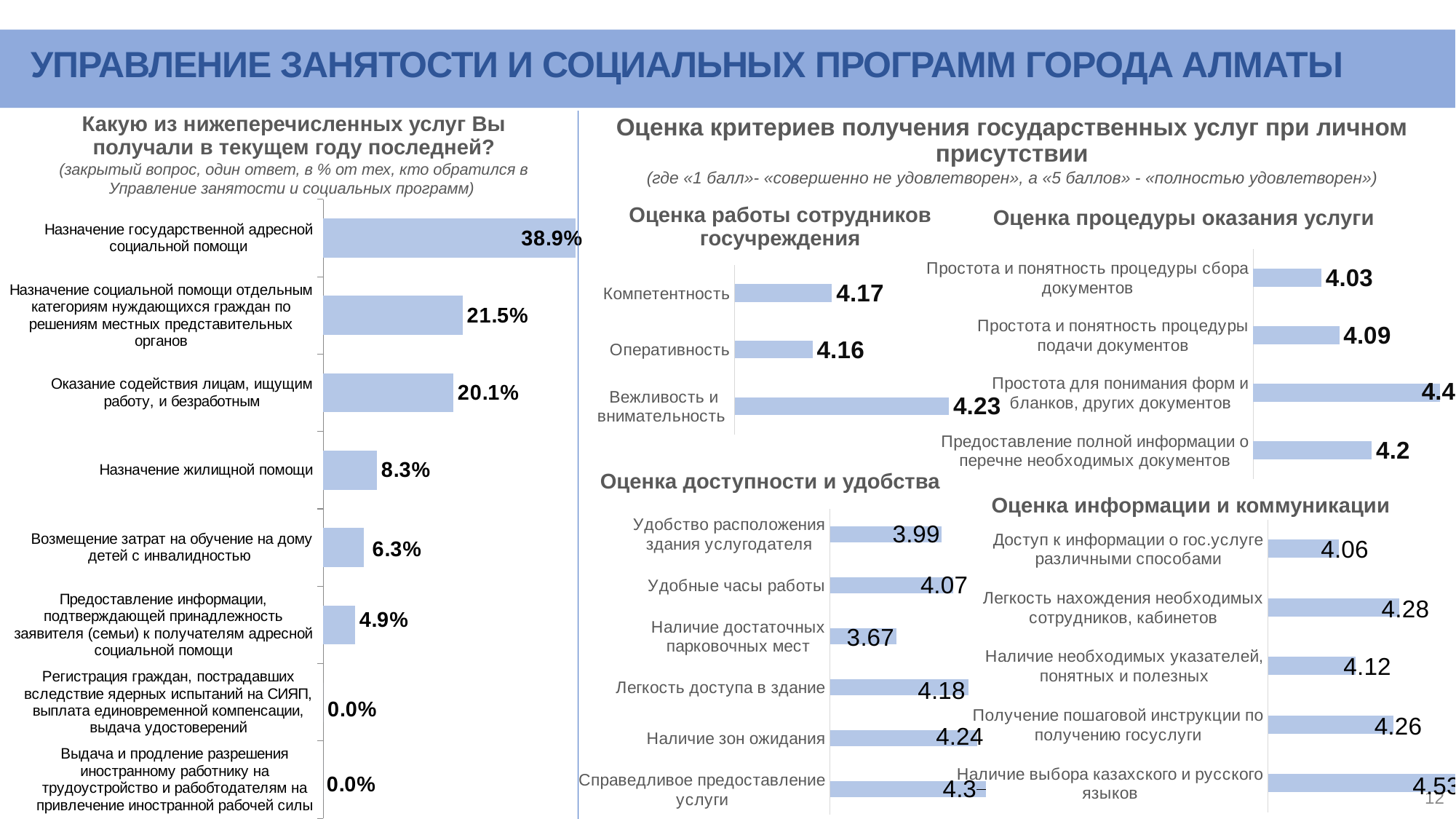
In the chart 'Какую из нижеперечисленных услуг Вы получали в текущем году последней?', what is the value for 'Назначение жилищной помощи'? 8.3% In the chart 'Оценка доступности и удобства', what is the value for 'Удобные часы работы'? 4.07 In the chart 'Какую из нижеперечисленных услуг Вы получали в текущем году последней?', what is the difference between 'Назначение социальной помощи отдельным категориям нуждающихся граждан по решениям местных представительных органов' and 'Оказание содействия лицам, ищущим работу, и безработным'? 1.4% In the chart 'Оценка информации и коммуникации', what is the value for 'Получение пошаговой инструкции по получению госуслуги'? 4.26 In the chart 'Оценка процедуры оказания услуги', which is larger: 'Простота и понятность процедуры подачи документов' or 'Предоставление полной информации о перечне необходимых документов'? Предоставление полной информации о перечне необходимых документов How many categories are shown in the chart 'Какую из нижеперечисленных услуг Вы получали в текущем году последней?'? 8 In the chart 'Оценка доступности и удобства', which category has the lowest value? Наличие достаточных парковочных мест In the chart 'Оценка работы сотрудников госучреждения', what is the value for 'Оперативность'? 4.16 In the chart 'Какую из нижеперечисленных услуг Вы получали в текущем году последней?', which category has the highest value? Назначение государственной адресной социальной помощи What type of chart is 'Оценка информации и коммуникации'? Bar chart In the chart 'Оценка работы сотрудников госучреждения', which category has the highest value? Вежливость и внимательность In the chart 'Оценка процедуры оказания услуги', what is the value for 'Простота и понятность процедуры сбора документов'? 4.03